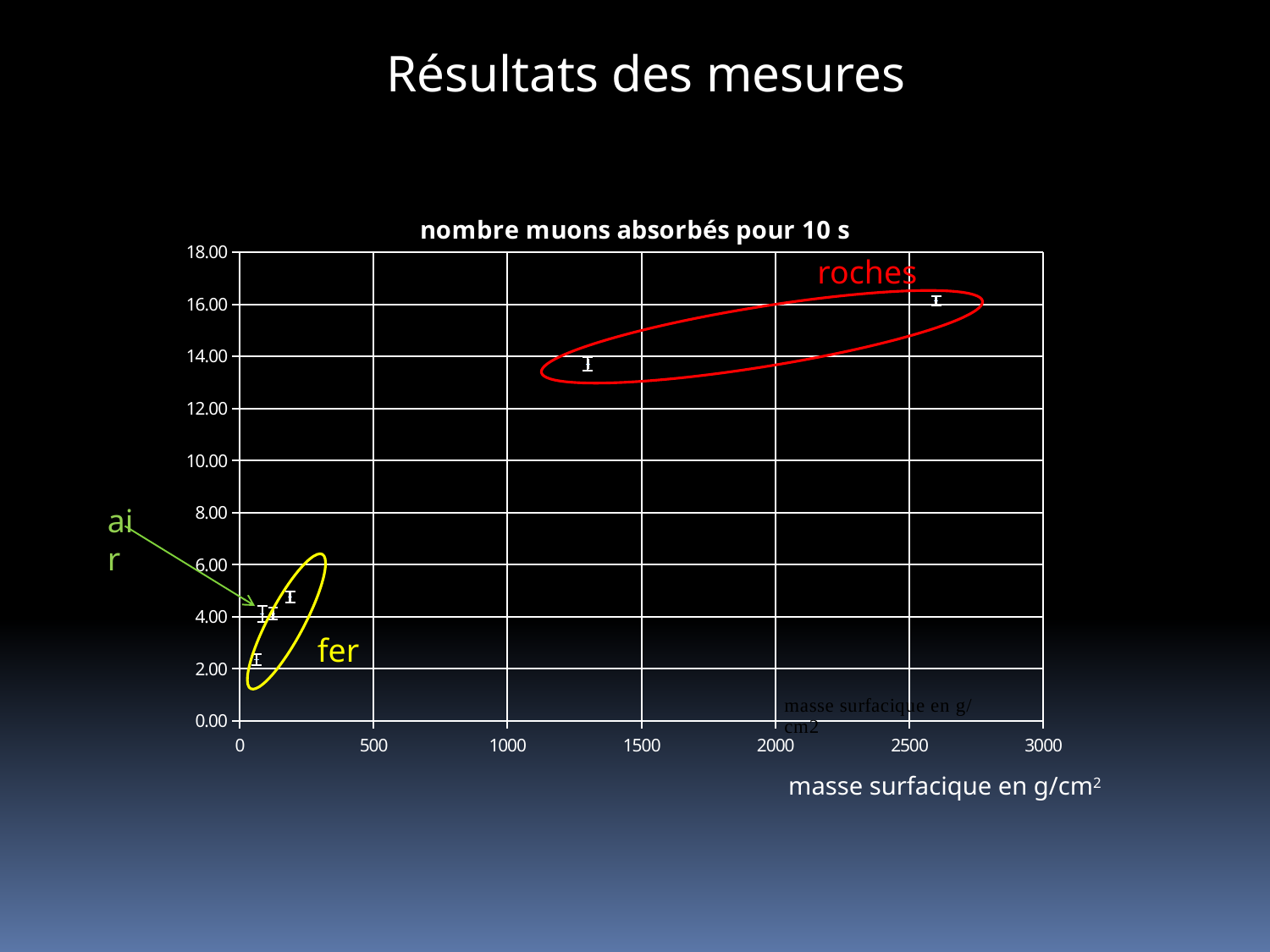
What kind of chart is shown on the slide? scatter chart What is the highest tick value shown on the y axis? 18.00 Is the value of the point at about 1300 g/cm2 greater or less than 14.00? less Is the value of the point at about 200 g/cm2 greater or less than 6.00? less Is the value of the lowest point, near 0 g/cm2, greater or less than 4.00? less What is the title of the chart? nombre muons absorbés pour 10 s What is the label of the x axis of the chart? masse surfacique en g/cm2 Which group of points has the highest values: 'fer' or 'roches'? roches How many data points are enclosed by the red ellipse labelled 'roches'? 2 Do the plotted values rise or fall as the masse surfacique increases along the x axis? rise